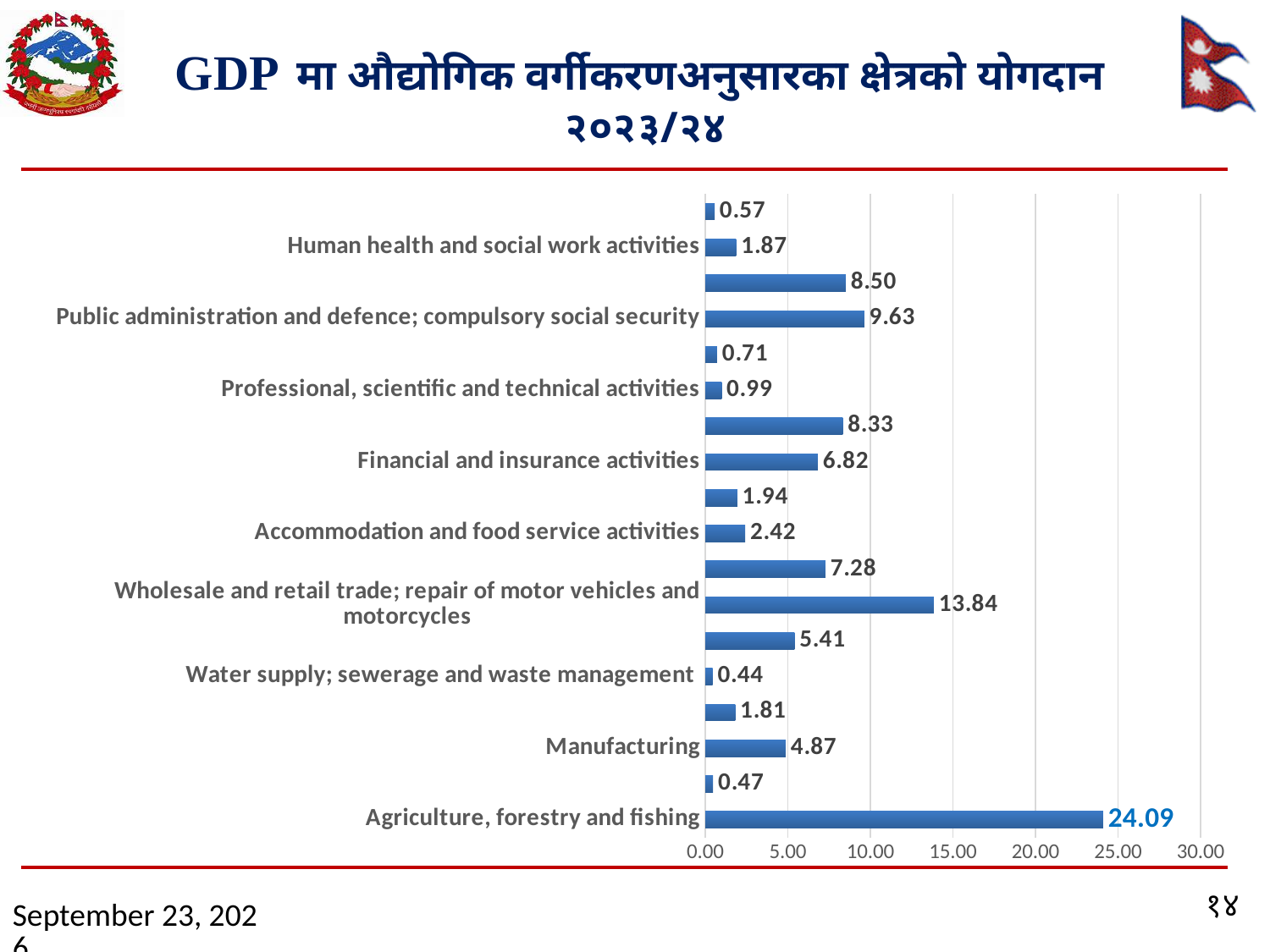
Which category has the highest value? Agriculture, forestry and fishing What is the value for Financial and insurance activities? 6.82 What is the value for Agriculture, forestry and fishing? 24.09 What is the value for Wholesale and retail trade; repair of motor vehicles and motorcycles? 13.84 What is the value for Manufacturing? 4.87 Which labelled category has the lowest value? Water supply; sewerage and waste management How many bars are plotted in the chart? 18 What is the difference between the values for Agriculture, forestry and fishing and Wholesale and retail trade; repair of motor vehicles and motorcycles? 10.25 What is the value for Public administration and defence; compulsory social security? 9.63 Which is larger, the value for Manufacturing or the value for Financial and insurance activities? Financial and insurance activities What kind of chart is shown on the slide? Bar chart Is the value for Agriculture, forestry and fishing greater or less than 20.00? greater